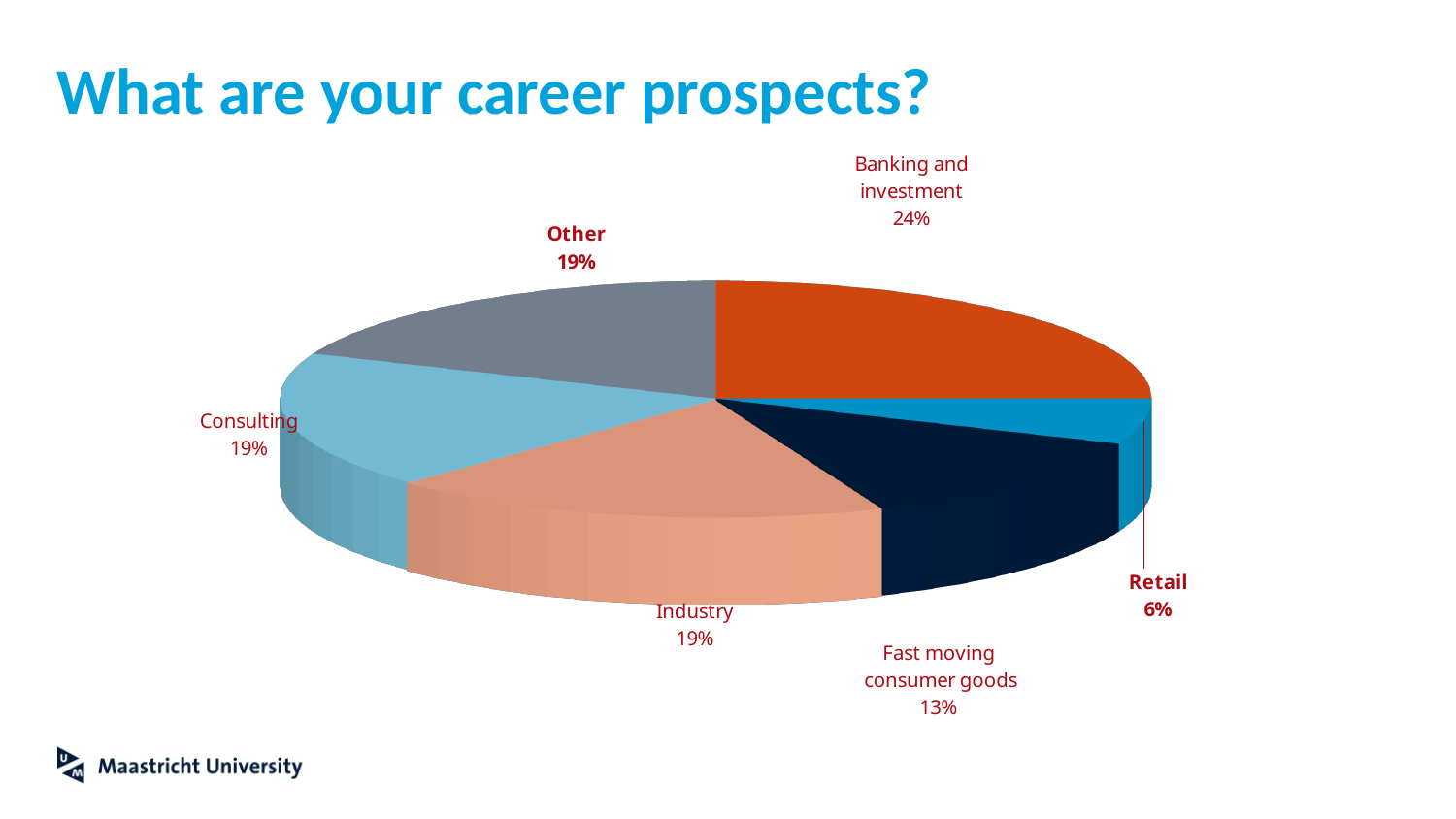
What percentage of respondents chose Banking and investment? 24% What is the title of the slide containing the chart? What are your career prospects? What is the difference between the Banking and investment share and the Retail share? 18% Which is larger, Fast moving consumer goods or Industry? Industry What is the value for Retail? 6% What is the value for Fast moving consumer goods? 13% How many categories are shown in the pie chart? 6 What is the difference between the Industry share and the Fast moving consumer goods share? 6% What is the value for Consulting? 19% What kind of chart is shown on the slide? Pie chart Which category has the largest share of the pie? Banking and investment Which category has the smallest share of the pie? Retail